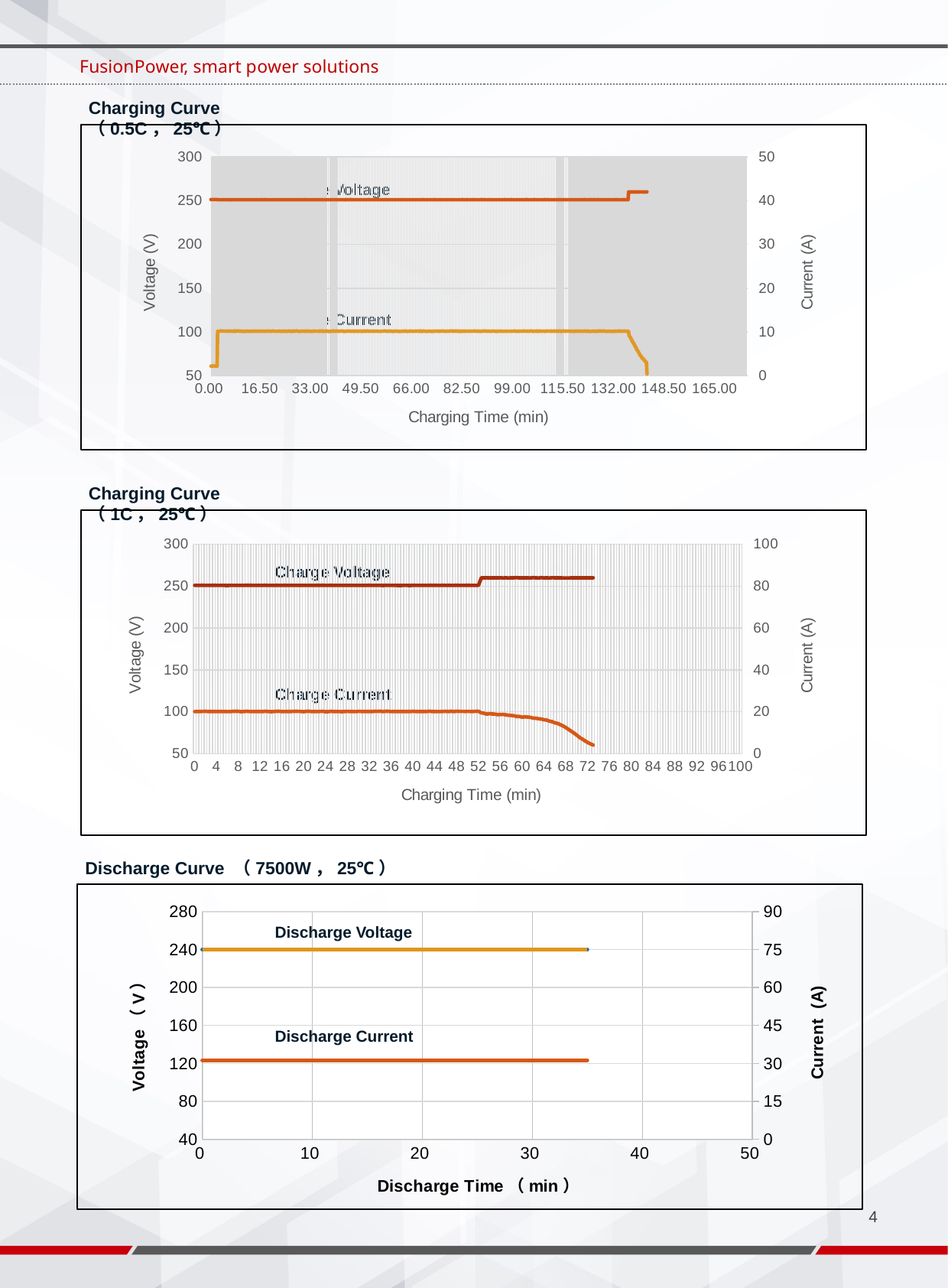
On the Charging Curve (0.5C, 25°C) chart, is the Charge Current line greater or less than 20 on the right-hand Current (A) axis? less What is the title of the right-hand vertical axis on the Charging Curve (0.5C, 25°C) chart? Current (A) How many series are plotted on the Charging Curve (1C, 25°C) chart? 2 On the Discharge Curve (7500W, 25°C) chart, what voltage does the Discharge Voltage line sit at? 240 On the Charging Curve (1C, 25°C) chart, does the Charge Current line rise or fall toward the end of the charging time? falls On the Discharge Curve (7500W, 25°C) chart, which line is plotted higher, Discharge Voltage or Discharge Current? Discharge Voltage What kind of chart is the Discharge Curve (7500W, 25°C) chart? line chart How many charts are shown on the slide? 3 On the Charging Curve (1C, 25°C) chart, does the Charge Voltage line rise or fall after about 52 minutes? rises On the Discharge Curve (7500W, 25°C) chart, is the Discharge Voltage line greater or less than 200 on the left-hand Voltage axis? greater On the Discharge Curve (7500W, 25°C) chart, is the Discharge Current line greater or less than 45 on the right-hand Current (A) axis? less